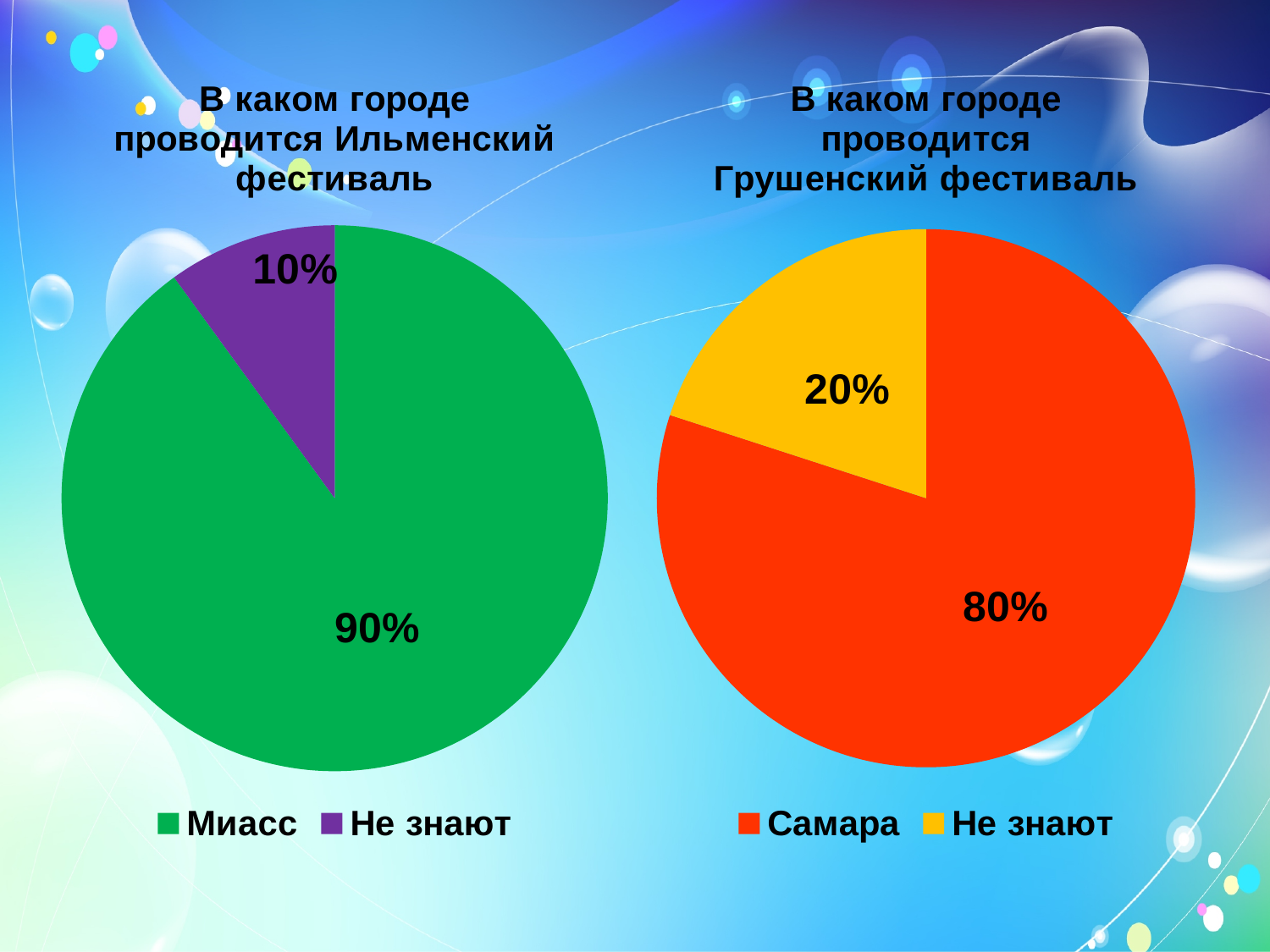
What type of chart is used on the left of the slide? pie chart In the left pie chart (Ильменский фестиваль), what colour is the Миасс slice? green In the left pie chart (Ильменский фестиваль), what share is labelled for Миасс? 90% In the left pie chart (Ильменский фестиваль), which category has the largest slice? Миасс In the right pie chart (Грушенский фестиваль), which category has the smallest slice? Не знают In the right pie chart (Грушенский фестиваль), what is the difference in percentage points between Самара and Не знают? 60 How many categories does the legend of the right pie chart (Грушенский фестиваль) list? 2 In the right pie chart (Грушенский фестиваль), what share is labelled for Не знают? 20% In the left pie chart (Ильменский фестиваль), what is the difference in percentage points between Миасс and Не знают? 80 In the right pie chart (Грушенский фестиваль), what share is labelled for Самара? 80% In the left pie chart (Ильменский фестиваль), what share is labelled for Не знают? 10% Which is larger: the Не знают share in the left pie chart or the Не знают share in the right pie chart? the right pie chart (20%)